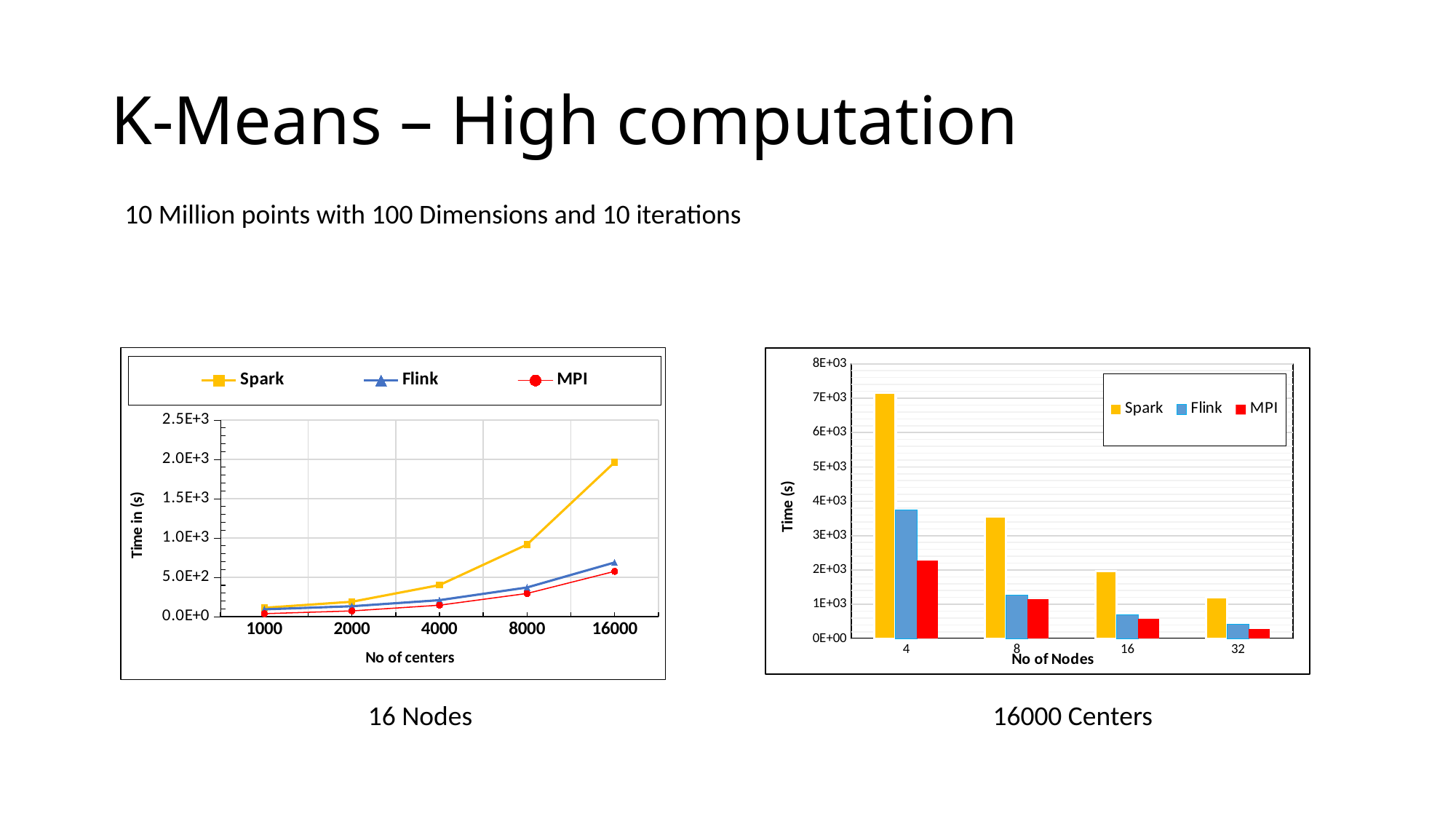
In the right chart (16000 Centers), which series has the highest value at 4 nodes? Spark How many series does the legend of the left chart (16 Nodes) list? 3 What kind of chart is the chart on the right (16000 Centers)? bar chart In the left chart (16 Nodes), is the Spark value at 16000 centers greater or less than 1.5E+3? greater What kind of chart is the chart on the left (16 Nodes)? line chart In the right chart (16000 Centers), is the Spark value at 4 nodes greater or less than 6E+03? greater In the right chart (16000 Centers), does the Spark time rise or fall as the number of nodes increases? fall In the right chart (16000 Centers), which series has the lowest value at 32 nodes? MPI How many categories are shown on the x axis of the right chart (16000 Centers)? 4 In the left chart (16 Nodes), does the Spark time rise or fall as the number of centers increases? rise In the left chart (16 Nodes), is the Spark value at 8000 centers greater or less than 1.0E+3? less How many points on the x axis (No of centers) does the left chart (16 Nodes) show? 5